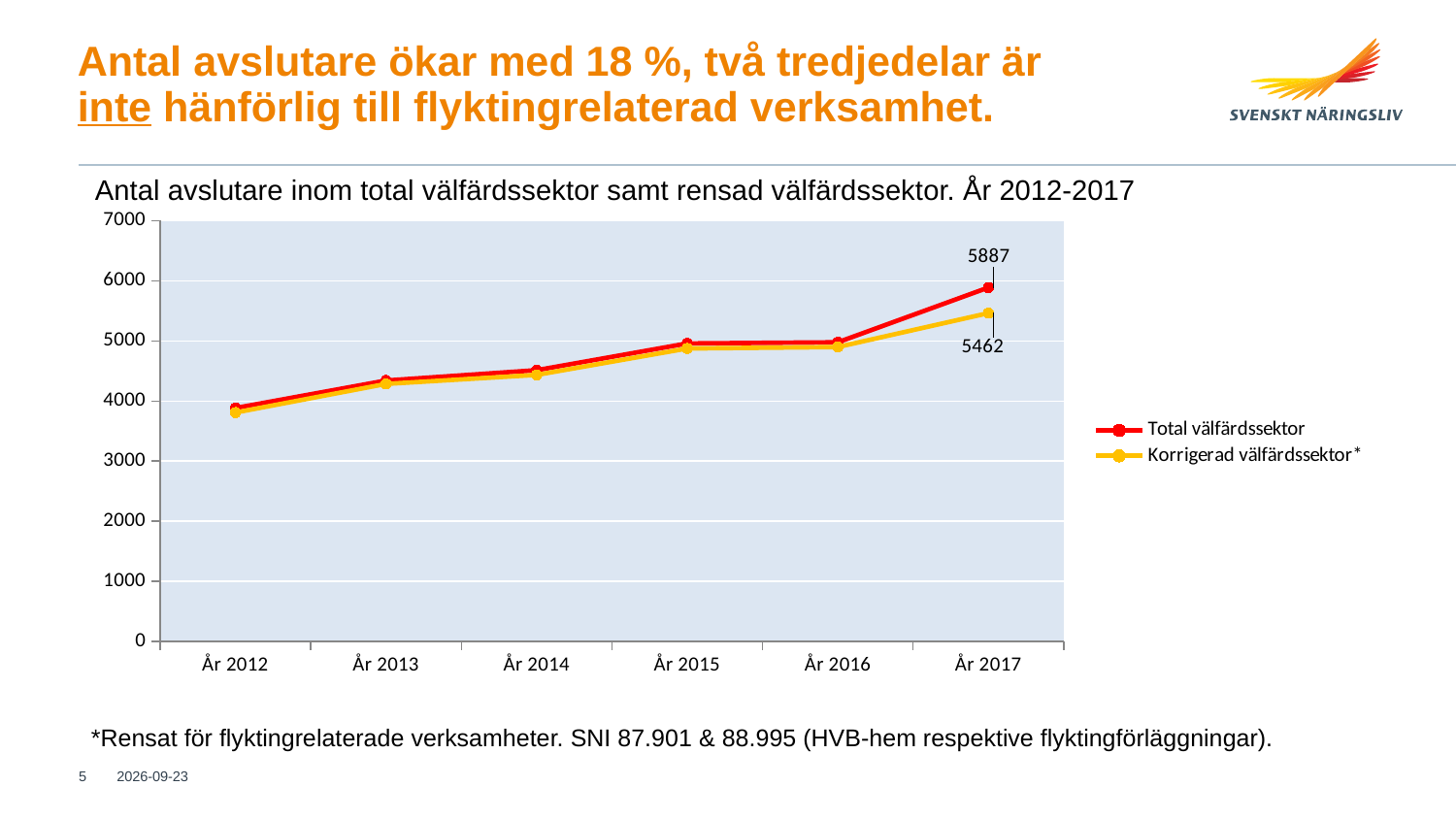
How many years are plotted on the x axis? 6 What kind of chart is shown on the slide? line chart What is the difference between Total välfärdssektor and Korrigerad välfärdssektor* in År 2017? 425 What is the value for Total välfärdssektor in År 2017? 5887 What is the value for Korrigerad välfärdssektor* in År 2017? 5462 Which series has the higher value in År 2017, Total välfärdssektor or Korrigerad välfärdssektor*? Total välfärdssektor In which year does Total välfärdssektor have its lowest value? År 2012 Do the values for Total välfärdssektor rise or fall from År 2012 to År 2017? rise How many series does the legend list? 2 Is the value for Korrigerad välfärdssektor* in År 2015 greater or less than 4000? greater Is the value for Total välfärdssektor in År 2012 greater or less than 4000? less In which year does Total välfärdssektor reach its highest value? År 2017